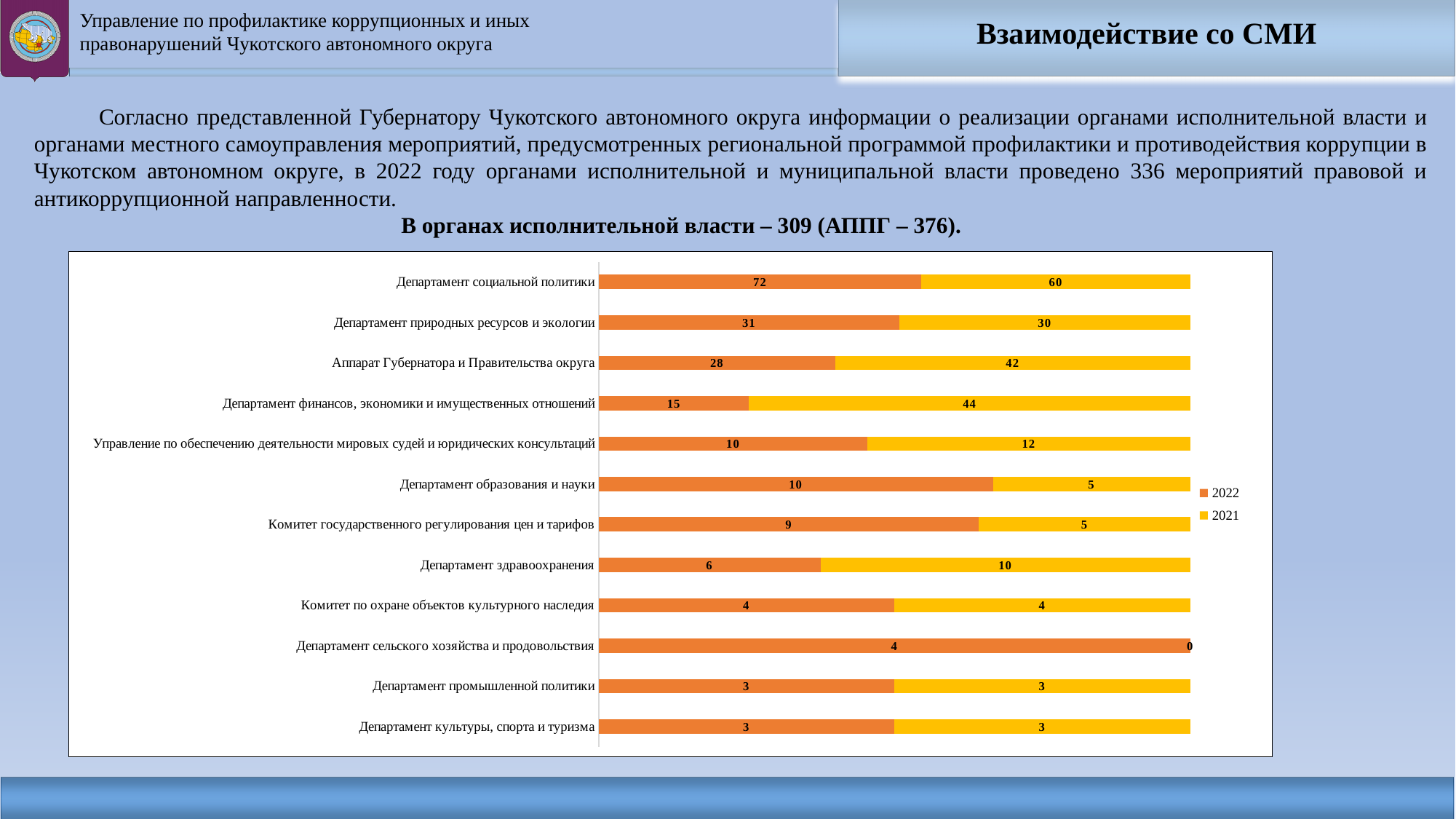
For Департамент здравоохранения, which is larger: the 2022 value or the 2021 value? 2021 Which category has the lowest 2021 value? Департамент сельского хозяйства и продовольствия What is the 2021 value for Департамент финансов, экономики и имущественных отношений? 44 How many series does the legend list? 2 What is the difference between the 2022 and 2021 values for Департамент социальной политики? 12 What is the 2022 value for Департамент социальной политики? 72 What kind of chart is shown on the slide? Stacked bar chart Which colour represents the 2021 series in the chart? Yellow Which category has the highest 2022 value? Департамент социальной политики What is the 2021 value for Аппарат Губернатора и Правительства округа? 42 What is the 2022 value for Департамент сельского хозяйства и продовольствия? 4 How many categories are shown on the chart? 12